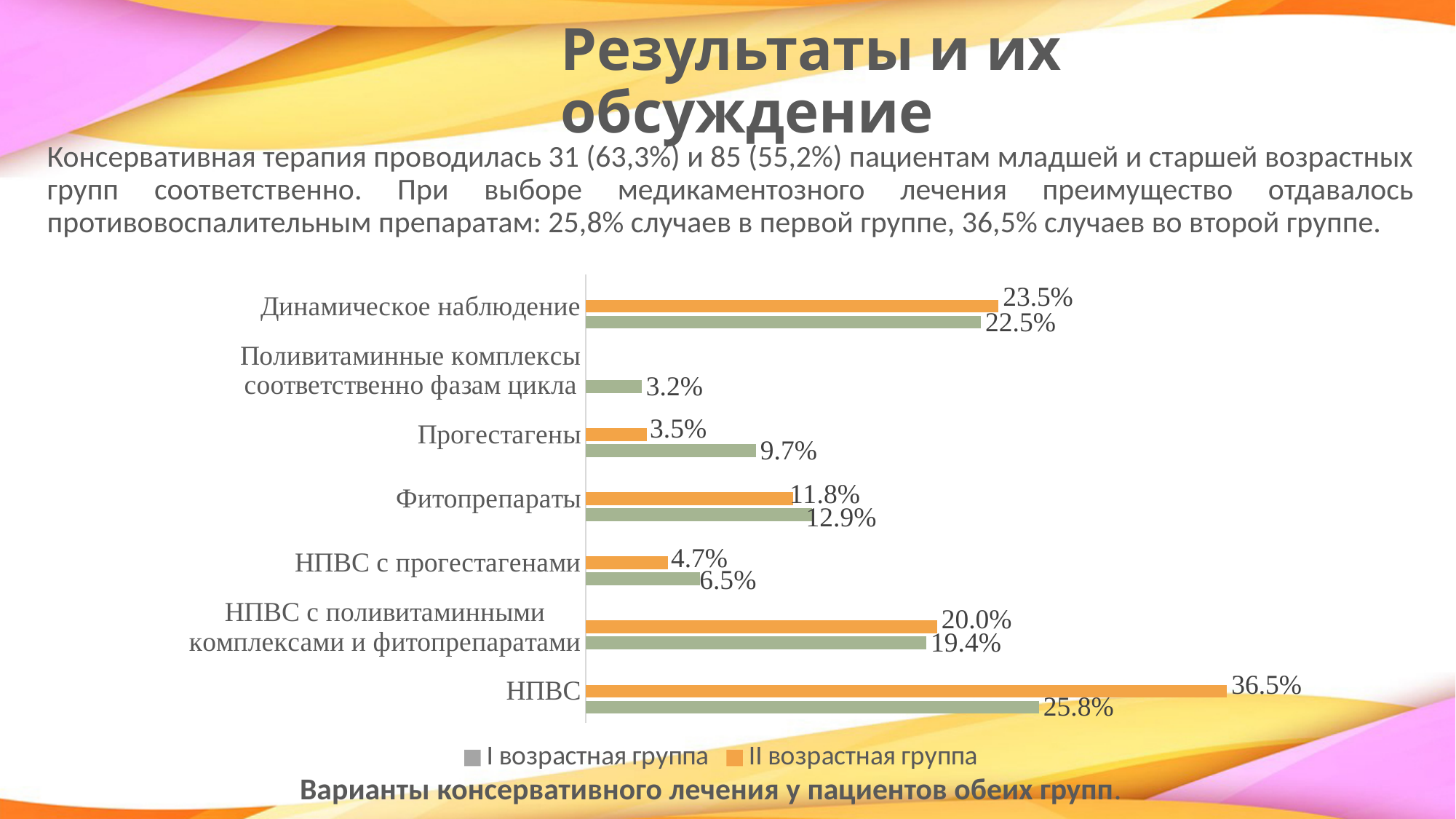
What is the value for НПВС in the II возрастная группа series? 36.5% Which category has the lowest value in the II возрастная группа series (among those with a bar)? Прогестагены What is the difference between the II возрастная группа and I возрастная группа values for НПВС? 10.7% What is the value for Прогестагены in the I возрастная группа series? 9.7% What is the difference between the I возрастная группа and II возрастная группа values for НПВС с прогестагенами? 1.8% Which category has the highest value in the I возрастная группа series? НПВС How many categories are shown on the chart? 7 How many series does the chart legend list? 2 For Прогестагены, which series has the larger value: I возрастная группа or II возрастная группа? I возрастная группа What type of chart is shown on the slide? bar chart What is the value for Фитопрепараты in the II возрастная группа series? 11.8% What is the title of the chart? Варианты консервативного лечения у пациентов обеих групп.